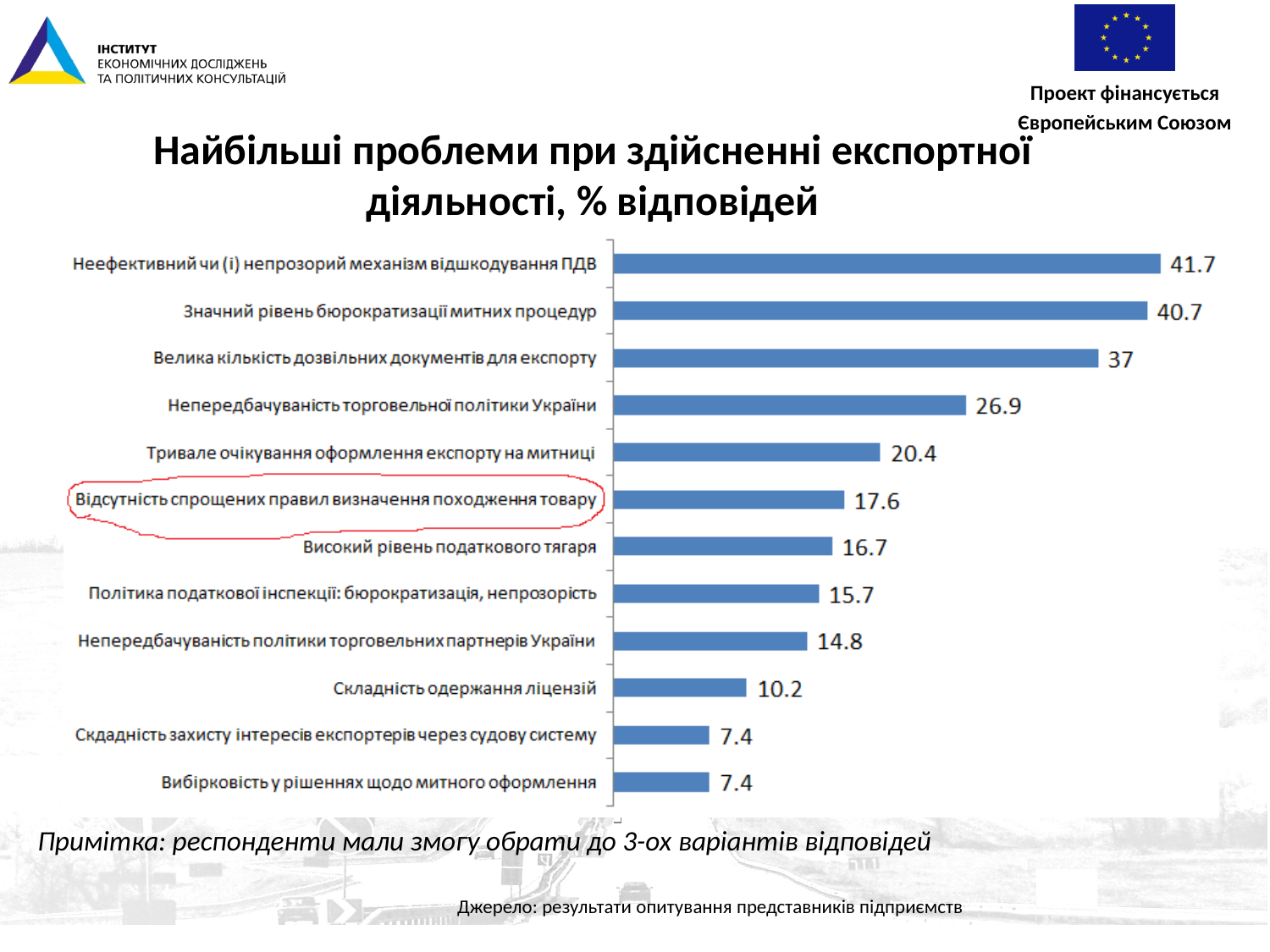
Which category has the highest value in the chart? Неефективний чи (і) непрозорий механізм відшкодування ПДВ Which category is circled in red on the chart? Відсутність спрощених правил визначення походження товару What is the difference between the values for "Непередбачуваність торговельної політики України" and "Тривале очікування оформлення експорту на митниці"? 6.5 What is the lowest value shown in the chart? 7.4 What is the title of the chart? Найбільші проблеми при здійсненні експортної діяльності, % відповідей How many categories (problems) are plotted in the chart? 12 What is the difference between the values for "Значний рівень бюрократизації митних процедур" and "Велика кількість дозвільних документів для експорту"? 3.7 What type of chart is shown on the slide? Bar chart Which is larger: the value for "Високий рівень податкового тягаря" or for "Непередбачуваність політики торговельних партнерів України"? Високий рівень податкового тягаря What is the value for "Неефективний чи (і) непрозорий механізм відшкодування ПДВ"? 41.7 What is the value for "Відсутність спрощених правил визначення походження товару"? 17.6 What is the value for "Складність одержання ліцензій"? 10.2